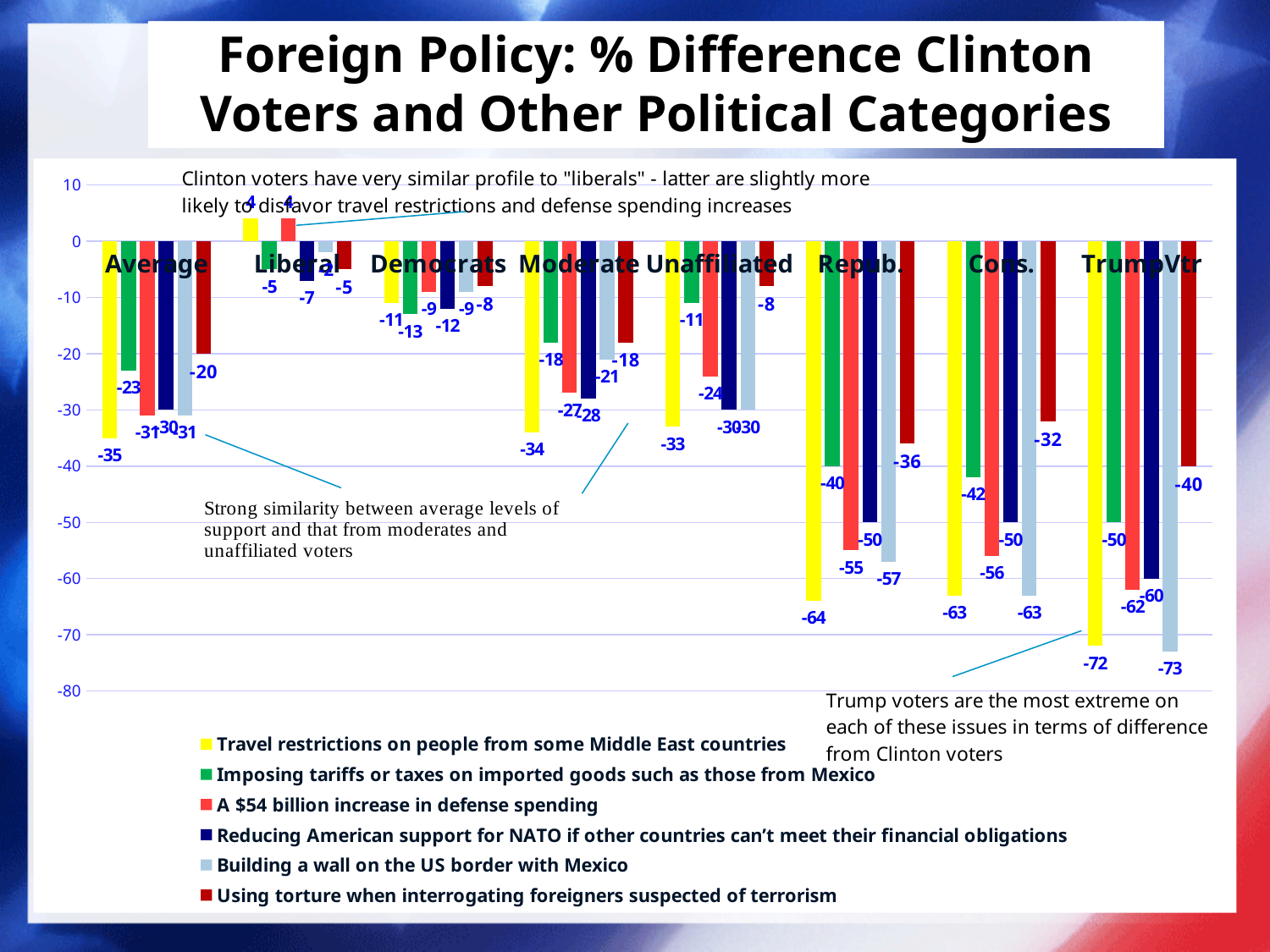
What is the value for 'Building a wall on the US border with Mexico' in the Repub. category? -57 What colour represents 'Travel restrictions on people from some Middle East countries' in the legend? Yellow What kind of chart is shown on the slide? Bar chart What is the value for 'A $54 billion increase in defense spending' in the Moderate category? -27 What is the value for 'Using torture when interrogating foreigners suspected of terrorism' in the TrumpVtr category? -40 How many series does the legend list? 6 How many political categories are shown on the x axis? 8 Which category has the highest value for 'Travel restrictions on people from some Middle East countries'? Liberal What is the value for 'Travel restrictions on people from some Middle East countries' in the Average category? -35 What is the difference between the 'Building a wall on the US border with Mexico' values for TrumpVtr and Average? 42 Which category has the lowest value for 'Travel restrictions on people from some Middle East countries'? TrumpVtr Which is larger, the 'Imposing tariffs or taxes on imported goods such as those from Mexico' value for Repub. or for Cons.? Repub.